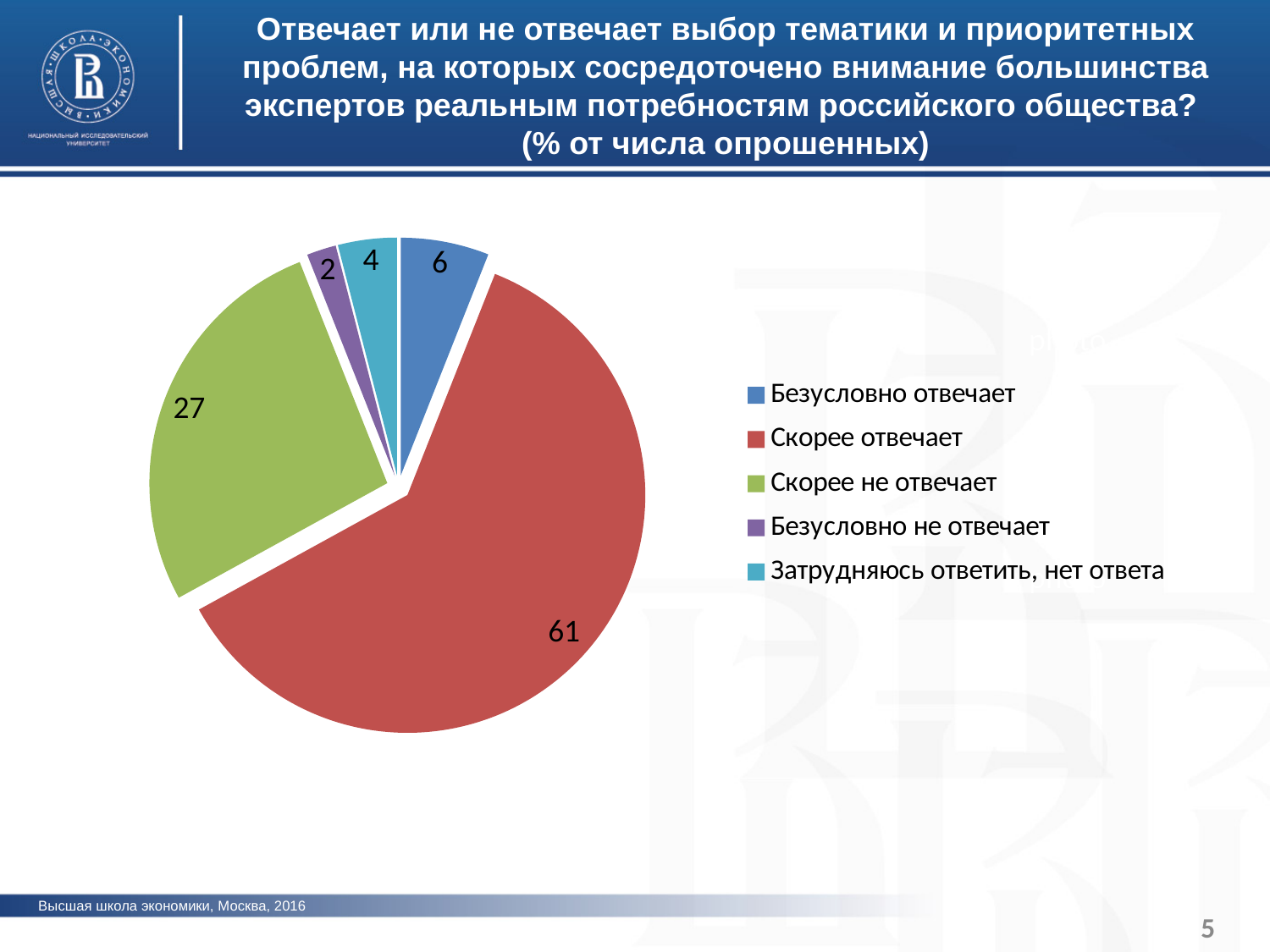
What is the difference between the values for "Скорее отвечает" and "Скорее не отвечает"? 34 What is the value for "Безусловно отвечает"? 6 Which category has the largest slice? Скорее отвечает Which is larger, the value for "Безусловно отвечает" or the value for "Затрудняюсь ответить, нет ответа"? Безусловно отвечает What is the value for "Скорее не отвечает"? 27 What colour is the slice for "Скорее не отвечает"? green What is the value for "Скорее отвечает"? 61 How many categories does the pie chart have? 5 Which category has the smallest slice? Безусловно не отвечает What is the value for "Затрудняюсь ответить, нет ответа"? 4 What is the value for "Безусловно не отвечает"? 2 What kind of chart is shown on the slide? pie chart